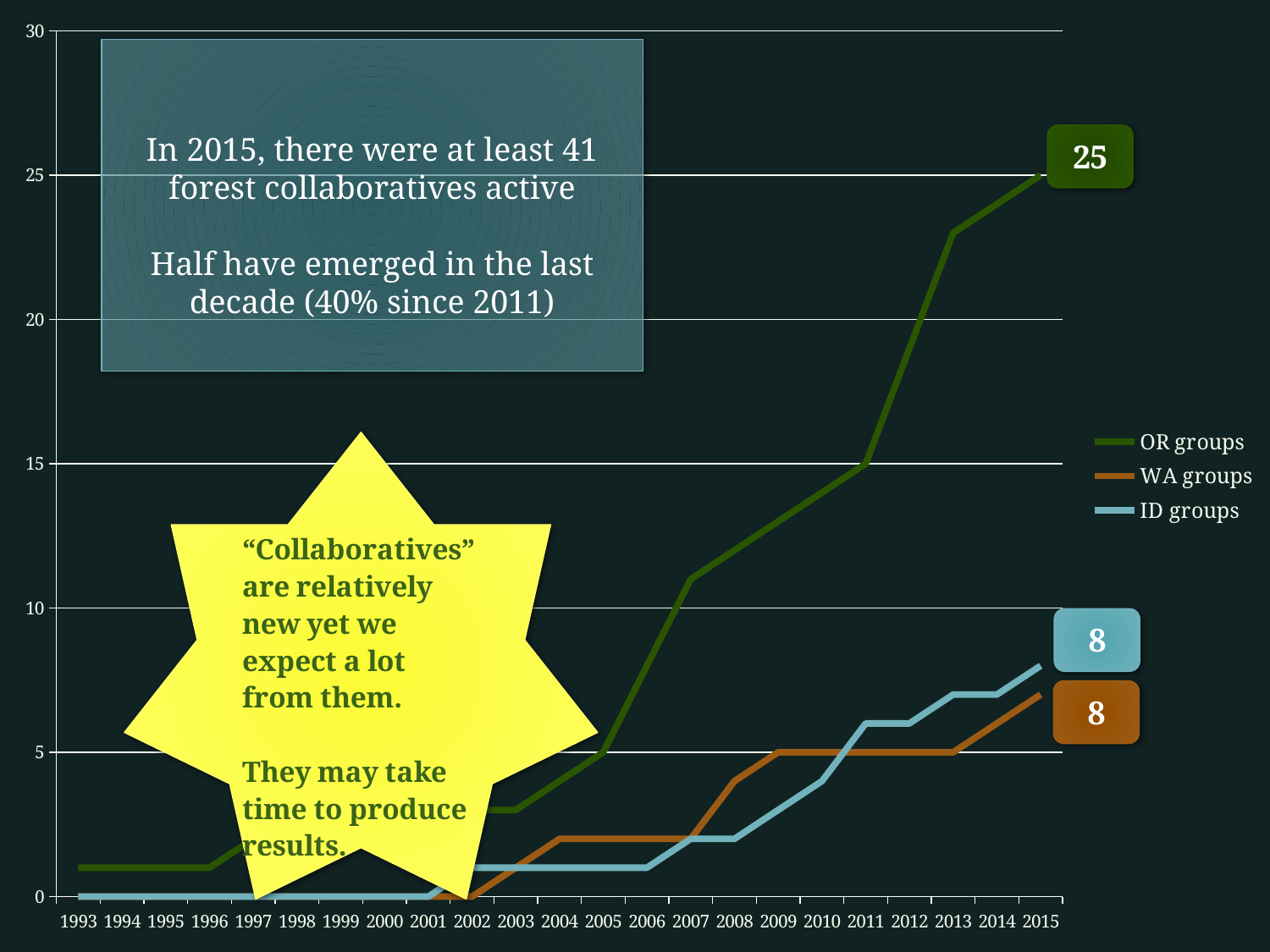
Is the value for OR groups in 2013 greater or less than 20? greater How many series does the legend list? 3 What type of chart is shown on the slide? line chart What is the value for OR groups in 2015? 25 How many years are shown on the x axis? 23 Which series has the highest value in 2015? OR groups Which is larger in 2015, the value for OR groups or the value for ID groups? OR groups Is the value for ID groups in 2010 greater or less than 5? less Does the OR groups line generally rise or fall from 1993 to 2015? rise What is the value for ID groups in 2015? 8 What is the value for WA groups in 2015? 8 What is the difference between the OR groups value and the WA groups value in 2015? 17